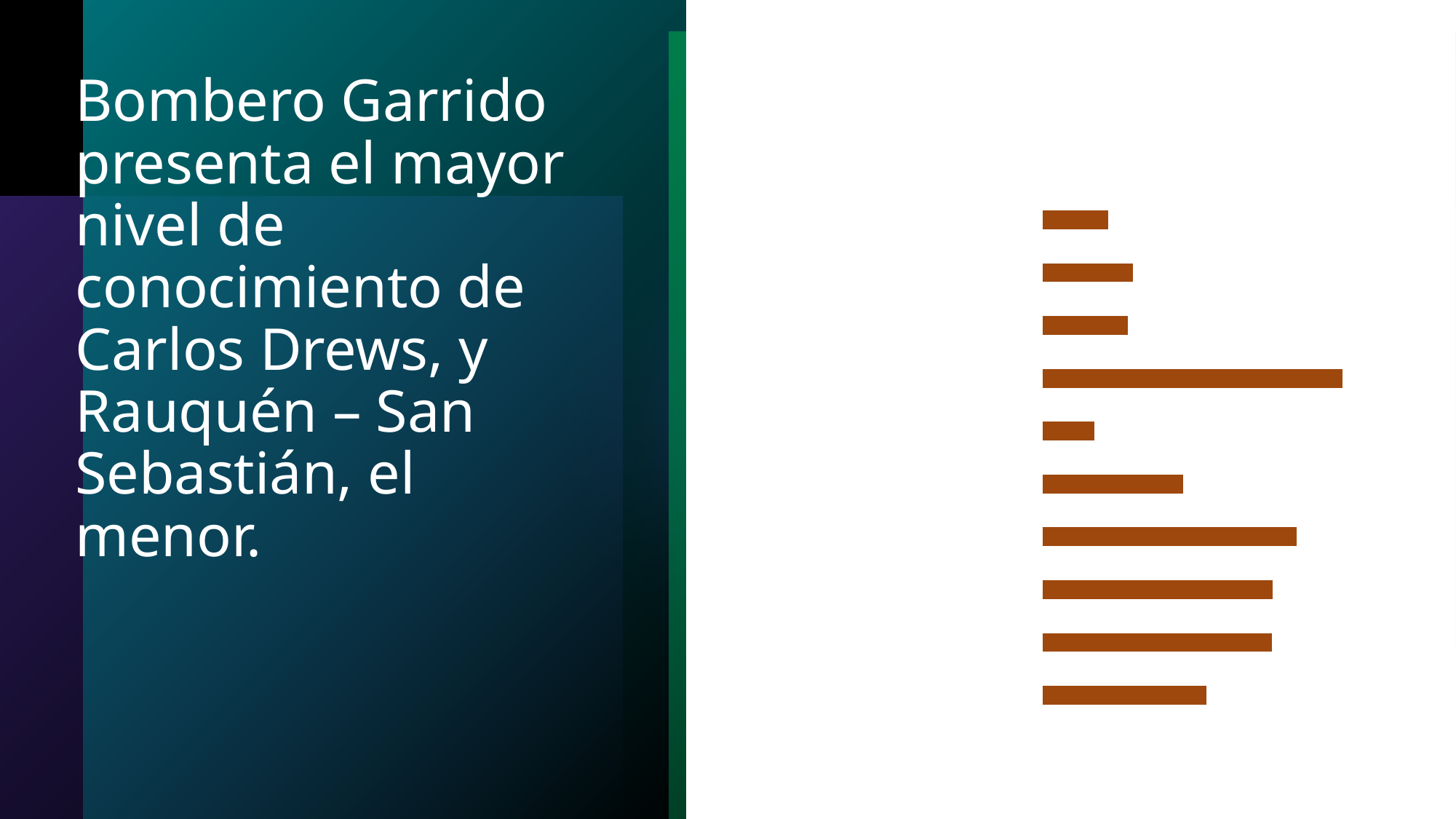
Counting from the top, which bar in the chart is the shortest? the 5th bar What kind of chart is shown on the right side of the slide? bar chart In the chart, is the 4th bar from the top longer or shorter than the 5th bar from the top? longer Are the bars in the chart drawn horizontally or vertically? horizontally In the chart, is the 1st bar from the top longer or shorter than the 7th bar from the top? shorter How many bars does the chart on the right side of the slide have? 10 What colour are the bars in the chart? brown Counting from the top, which bar in the chart is the longest? the 4th bar